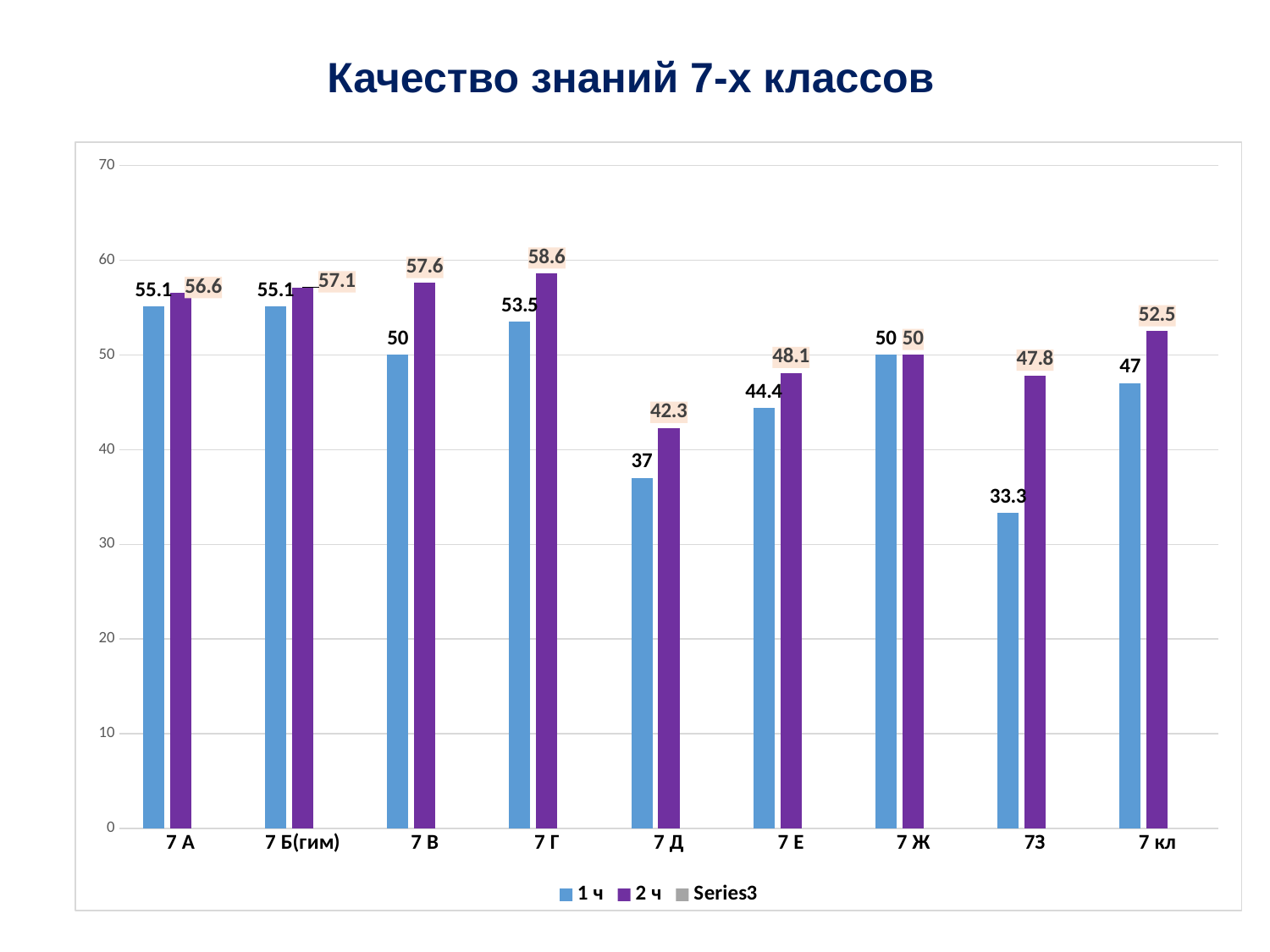
What is the value of the 2 ч series for 7 Г? 58.6 Is the 1 ч value for 7 Ж greater or less than 40? greater Which category has the lowest value in the 1 ч series? 73 What is the value of the 2 ч series for 7 кл? 52.5 How many series does the legend list? 3 What is the value of the 1 ч series for 7 Д? 37 For 7 Е, which series has the larger value, 1 ч or 2 ч? 2 ч What is the title of the chart? Качество знаний 7-х классов What is the difference between the 2 ч and 1 ч values for 7 В? 7.6 Which category has the highest value in the 2 ч series? 7 Г How many categories are shown on the x axis? 9 What is the difference between the 2 ч and 1 ч values for 7 Д? 5.3